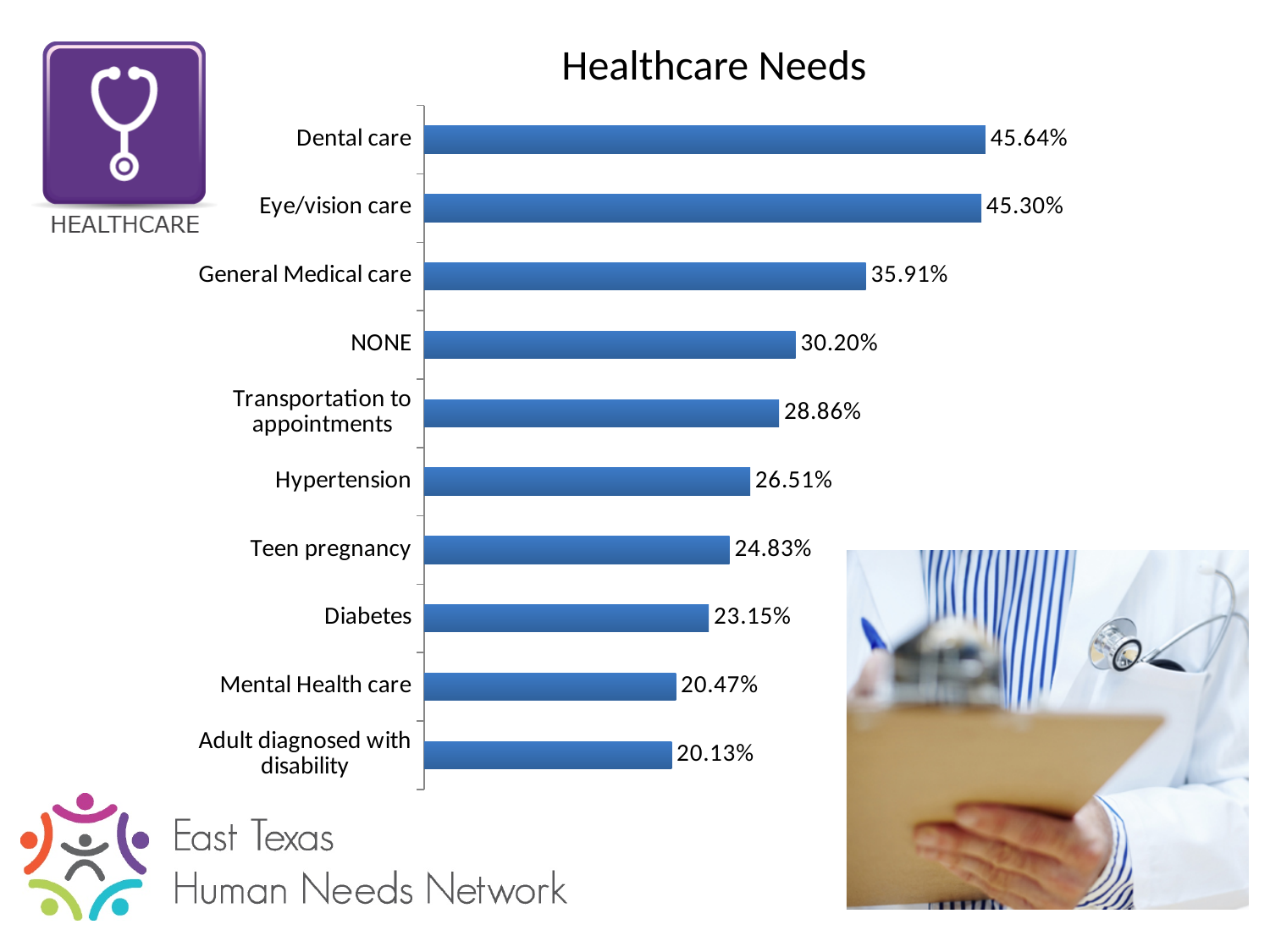
What is the difference between Hypertension and Diabetes? 3.36% What is the difference between General Medical care and NONE? 5.71% What kind of chart is this? Bar chart Which category has the lowest value? Adult diagnosed with disability Which is larger, Teen pregnancy or Diabetes? Teen pregnancy What is the title of the chart? Healthcare Needs Which category has the highest value? Dental care What is the value for Transportation to appointments? 28.86% How many categories are shown in the chart? 10 What is the value for Mental Health care? 20.47% Which is larger, General Medical care or Hypertension? General Medical care What is the value for Dental care? 45.64%